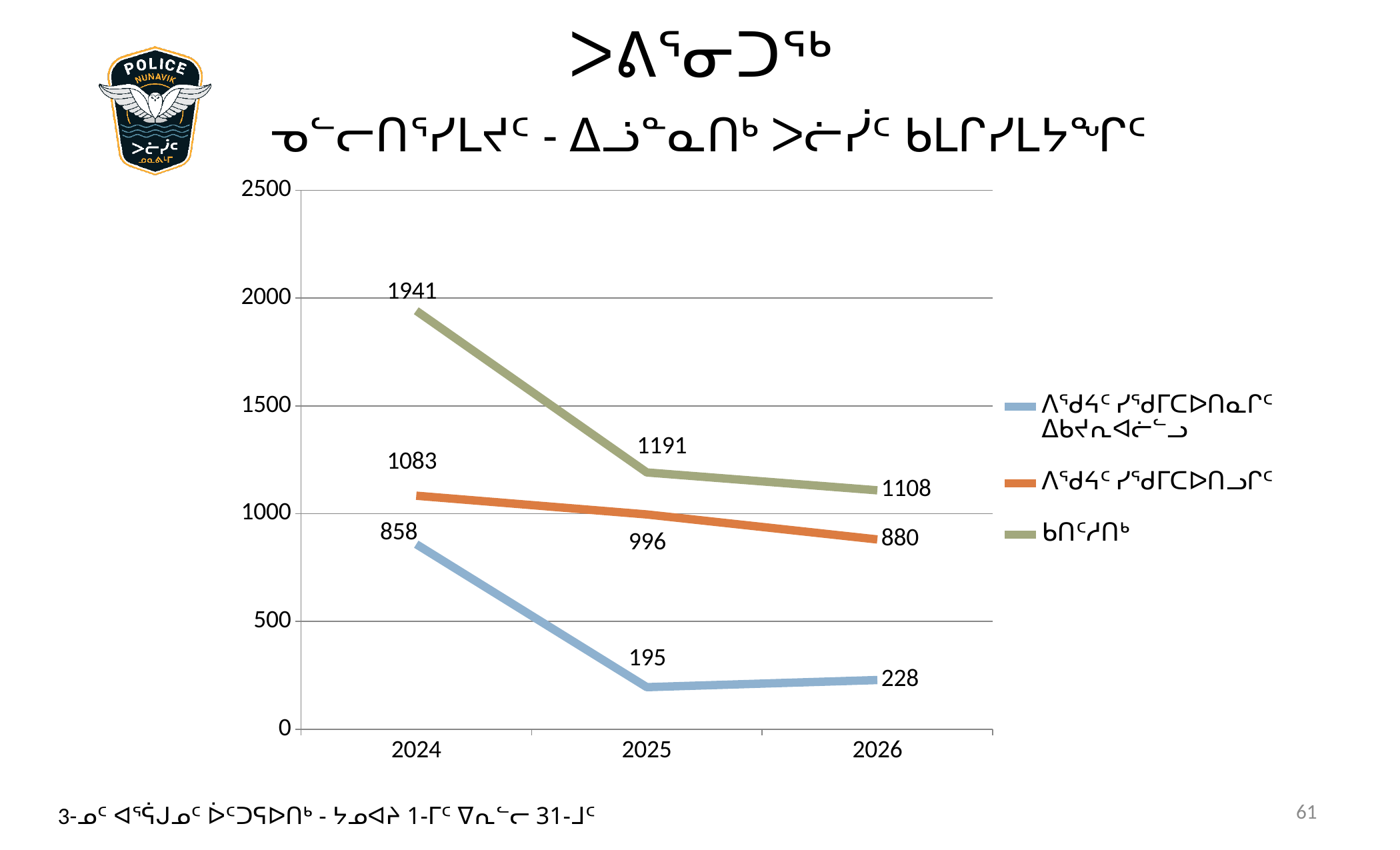
What is the value of the orange line in 2026? 880 What is the difference between the green line's values in 2024 and 2025? 750 What is the value of the green line in 2024? 1941 In 2025, which line has the larger value, the orange line or the blue line? orange What kind of chart is shown on the slide? line chart How many years are shown on the x axis? 3 How many series does the legend list? 3 What is the difference between the blue line's values in 2026 and 2025? 33 In which year does the blue line reach its lowest value? 2025 In which year does the green line reach its highest value? 2024 What is the value of the blue line in 2025? 195 Does the orange line rise or fall from 2024 to 2026? fall